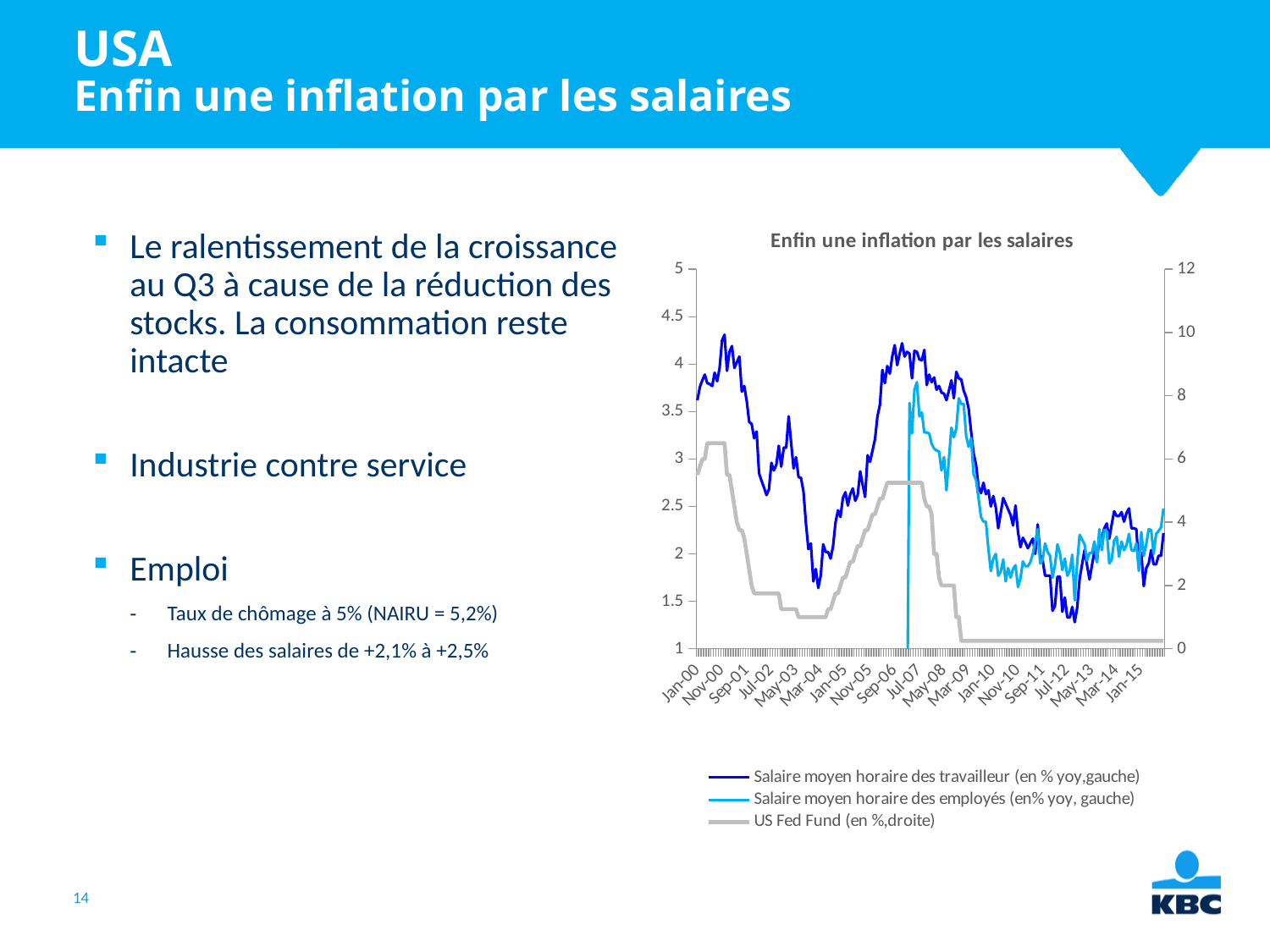
Is the value of Salaire moyen horaire des travailleur (left axis) around Jul-12 greater or less than 2? less How many series does the chart legend list? 3 What is the title of the chart? Enfin une inflation par les salaires Which series in the chart is plotted against the right-hand axis? US Fed Fund (en %,droite) What kind of chart is shown on the slide? line chart Does the Salaire moyen horaire des travailleur series rise or fall between Sep-06 and Jan-10? fall What is the highest tick value shown on the left-hand axis of the chart? 5 Is the value of Salaire moyen horaire des travailleur (left axis) at Jan-00 greater or less than 3? greater Is the value of US Fed Fund (right axis) at Jan-00 greater or less than 4? greater Does the US Fed Fund series rise or fall between Sep-06 and Jan-10? fall